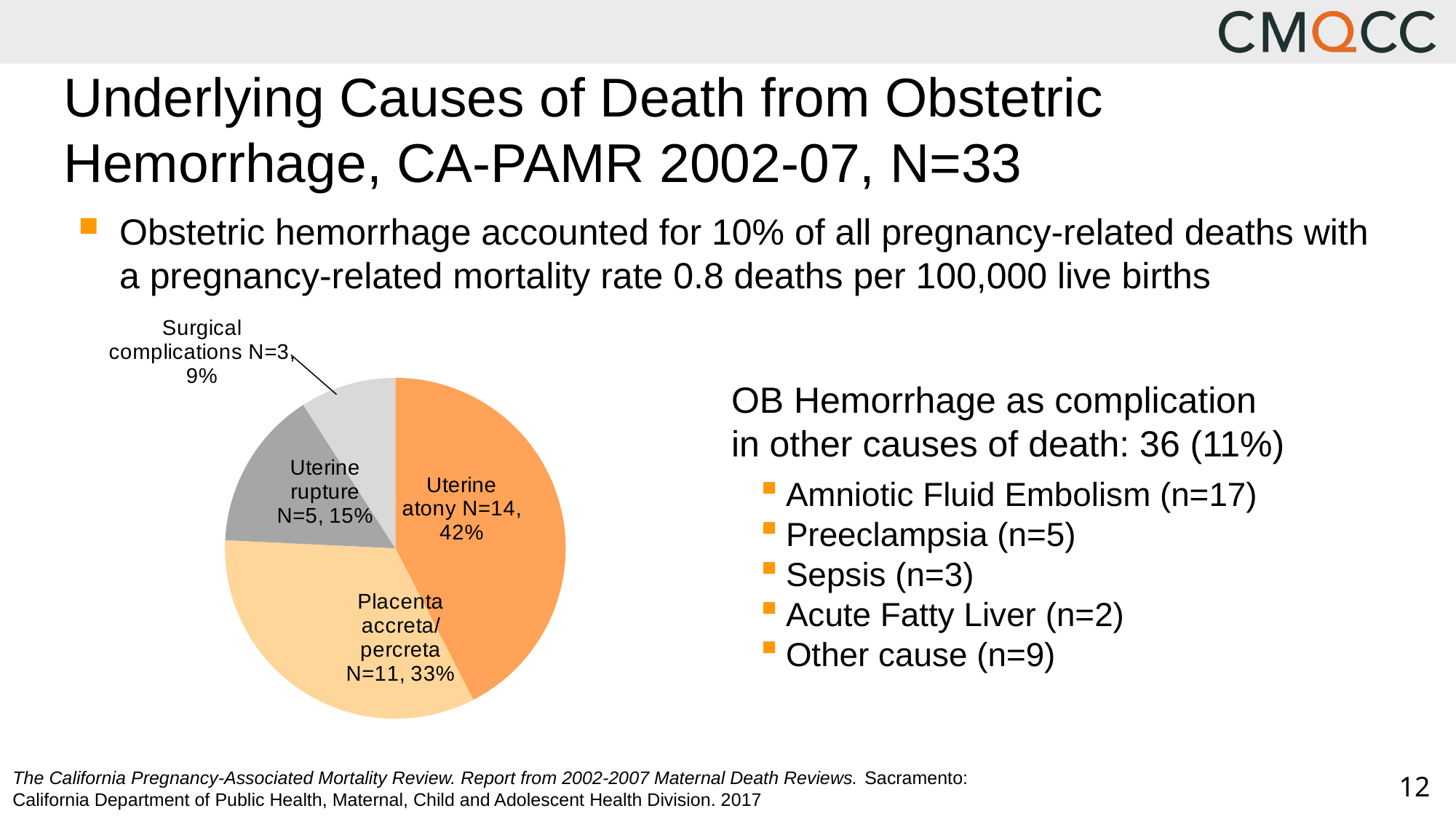
What is the total N across all slices of the pie chart? 33 What is the N value for Uterine atony in the pie chart? N=14 What percentage of the pie does Surgical complications represent? 9% What colour is the Uterine atony slice in the pie chart? Orange Which cause has the largest slice in the pie chart? Uterine atony How many slices does the pie chart have? 4 Which has a larger share of the pie, Uterine rupture or Surgical complications? Uterine rupture What is the difference in N between Uterine atony and Placenta accreta/percreta? 3 What kind of chart is shown on the slide? Pie chart Which cause has the smallest slice in the pie chart? Surgical complications What percentage of the pie does Placenta accreta/percreta represent? 33% What is the N value for Uterine rupture in the pie chart? N=5